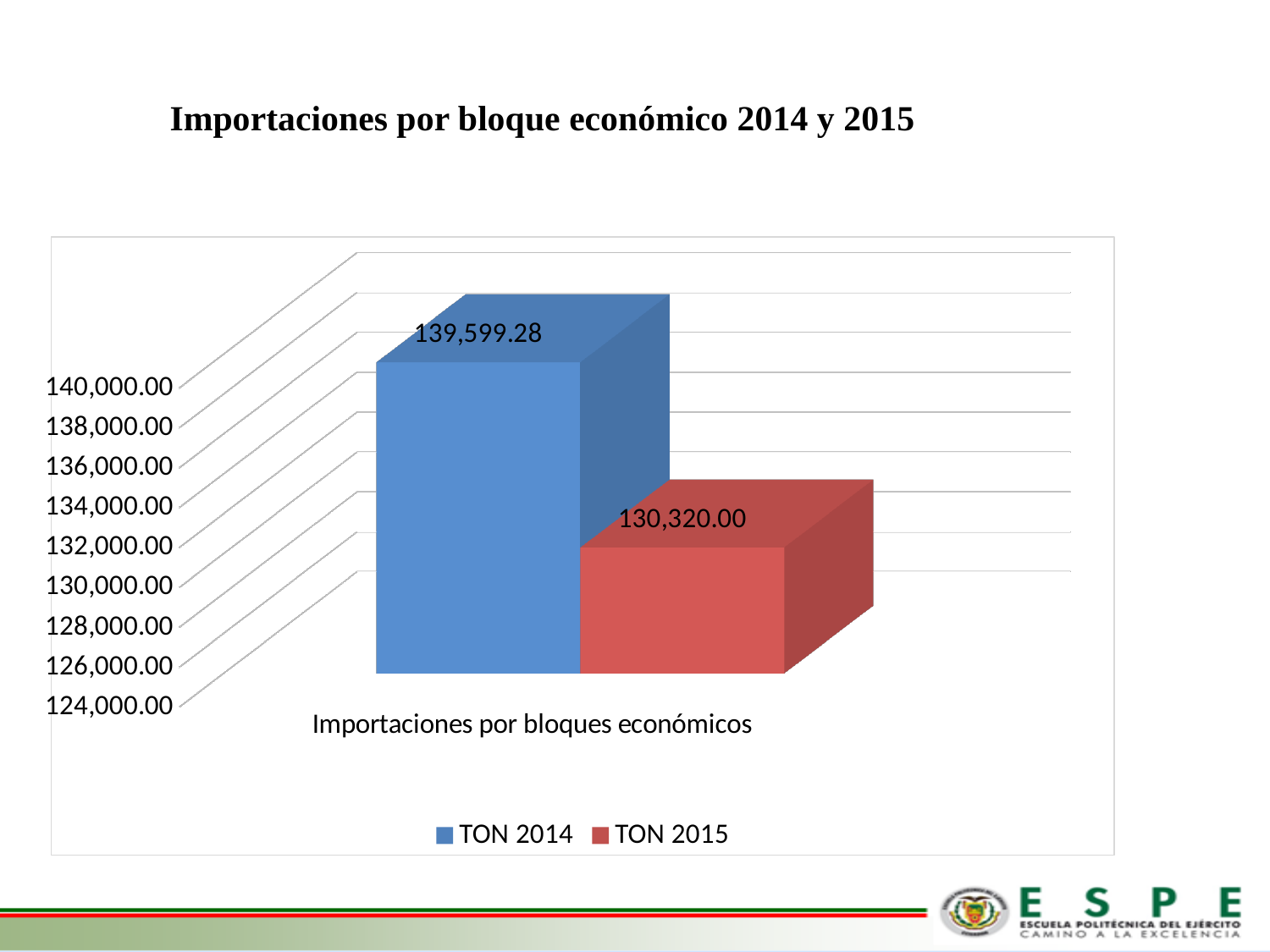
Which series has the highest value? TON 2014 What is the title of the slide above the chart? Importaciones por bloque económico 2014 y 2015 What is the value for TON 2015? 130,320.00 What kind of chart is shown on the slide? Bar chart Is the value for TON 2015 greater or less than 134,000.00? less Which series has the higher value, TON 2014 or TON 2015? TON 2014 What is the value for TON 2014? 139,599.28 How many categories are shown on the x axis? 1 Is the value for TON 2014 greater or less than 136,000.00? greater What is the difference between the TON 2014 value and the TON 2015 value? 9,279.28 Which series has the lowest value? TON 2015 How many series does the legend list? 2